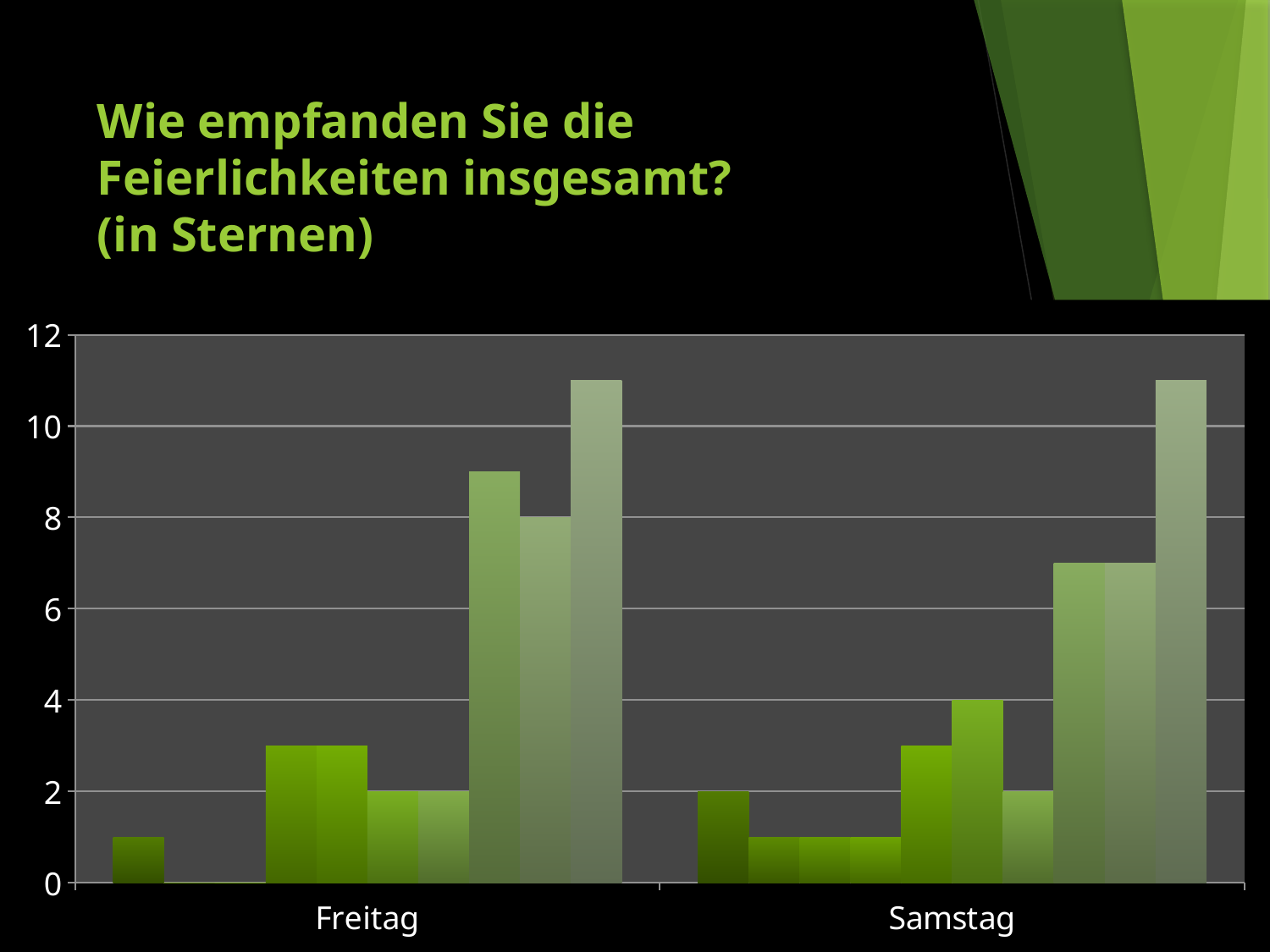
What kind of chart is shown on the slide? bar chart What is the highest value shown on the y axis of the chart? 12 Is the tallest bar in the Freitag group greater or less than 10? greater What are the two categories on the x axis of the chart? Freitag and Samstag How many categories are shown on the x axis of the chart? 2 Which group has the taller second-highest bar, Freitag or Samstag? Freitag Is the tallest bar in the Samstag group greater or less than 8? greater